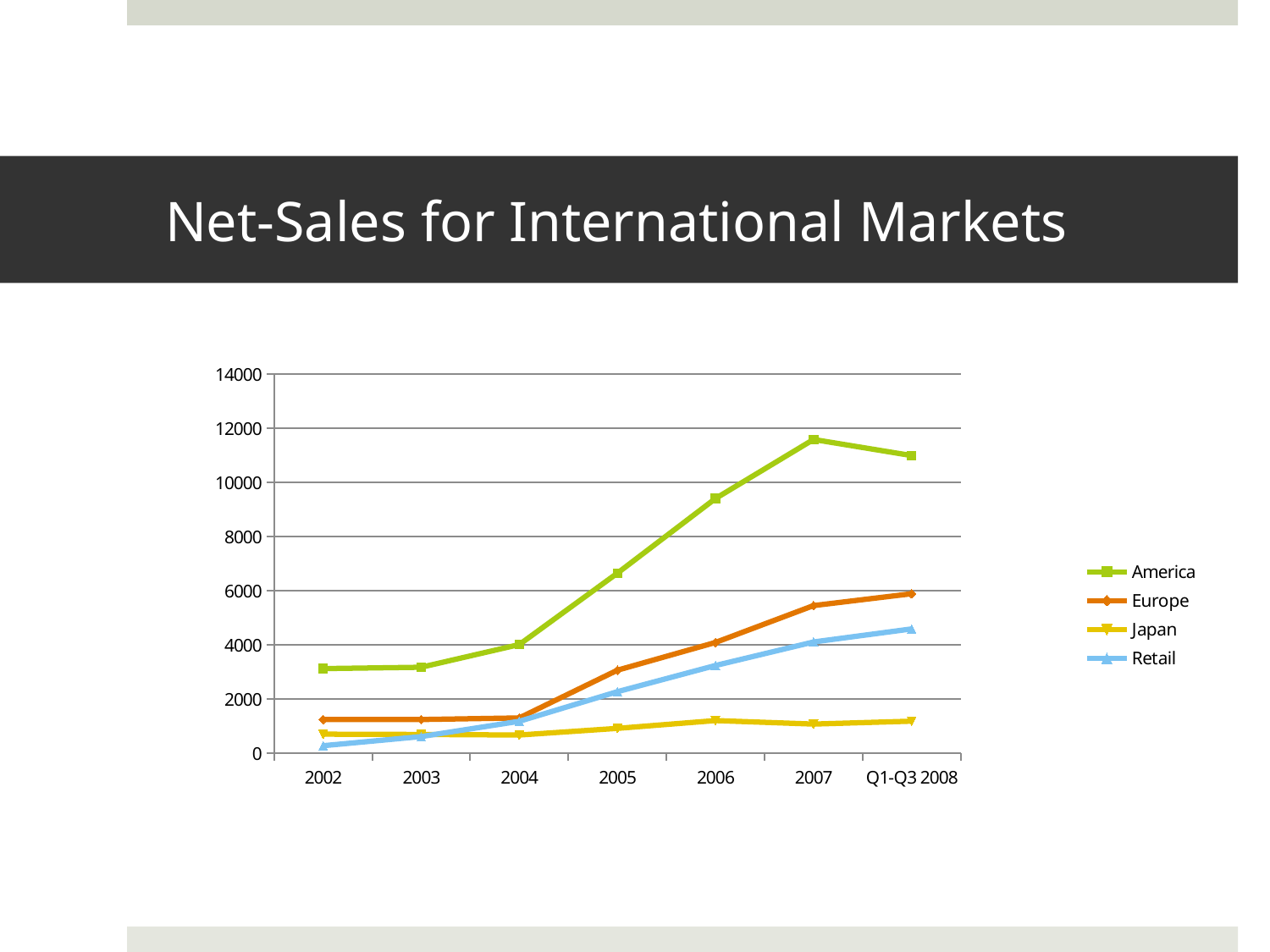
Which series has the highest value in 2007? America Which is larger in 2005, the value for Europe or the value for Japan? Europe Is the value for America in 2007 greater or less than 10000? greater Is the value for Europe in 2006 greater or less than 6000? less What is the title of the slide containing the chart? Net-Sales for International Markets How many series does the legend list? 4 Does the America series rise or fall from 2007 to Q1-Q3 2008? fall Which series has the lowest value in Q1-Q3 2008? Japan How many time periods are plotted along the x axis? 7 Is the value for Retail in 2002 greater or less than 2000? less Does the Europe series generally rise or fall from 2002 to Q1-Q3 2008? rise What kind of chart is shown on the slide? line chart